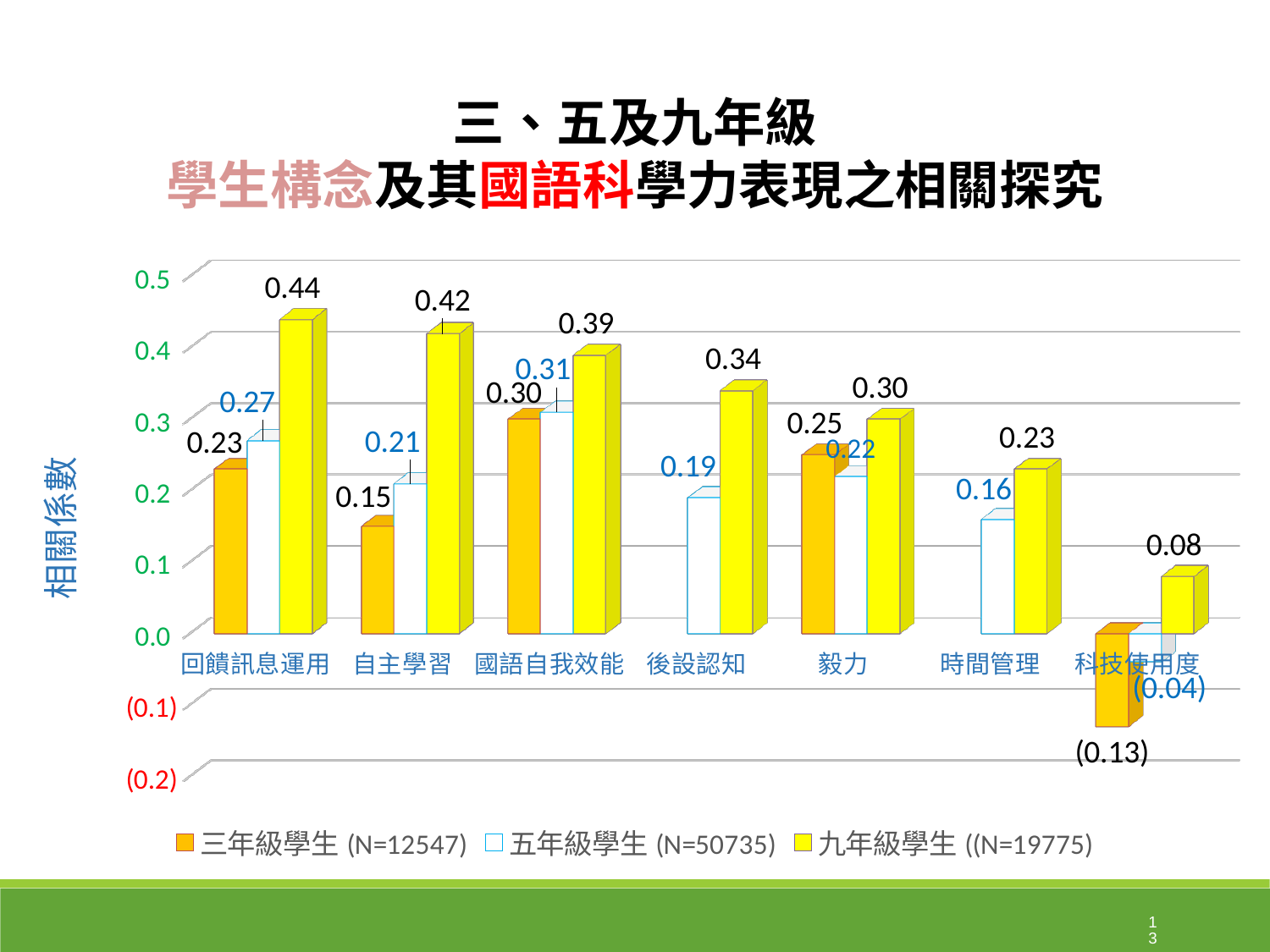
Which category has the lowest value for 五年級學生? 科技使用度 Which category has the highest value for 九年級學生? 回饋訊息運用 What is the difference between the 九年級學生 and 三年級學生 values in the 回饋訊息運用 category? 0.21 How many categories are shown on the x axis? 7 How many series does the legend list? 3 What is the value for 三年級學生 in the 自主學習 category? 0.15 In the 毅力 category, which is larger: the value for 三年級學生 or for 五年級學生? 三年級學生 What is the value for 五年級學生 in the 時間管理 category? 0.16 What kind of chart is shown on the slide? Bar chart What is the value for 三年級學生 in the 科技使用度 category? (0.13) What is the value for 九年級學生 in the 回饋訊息運用 category? 0.44 What is the label of the vertical axis? 相關係數